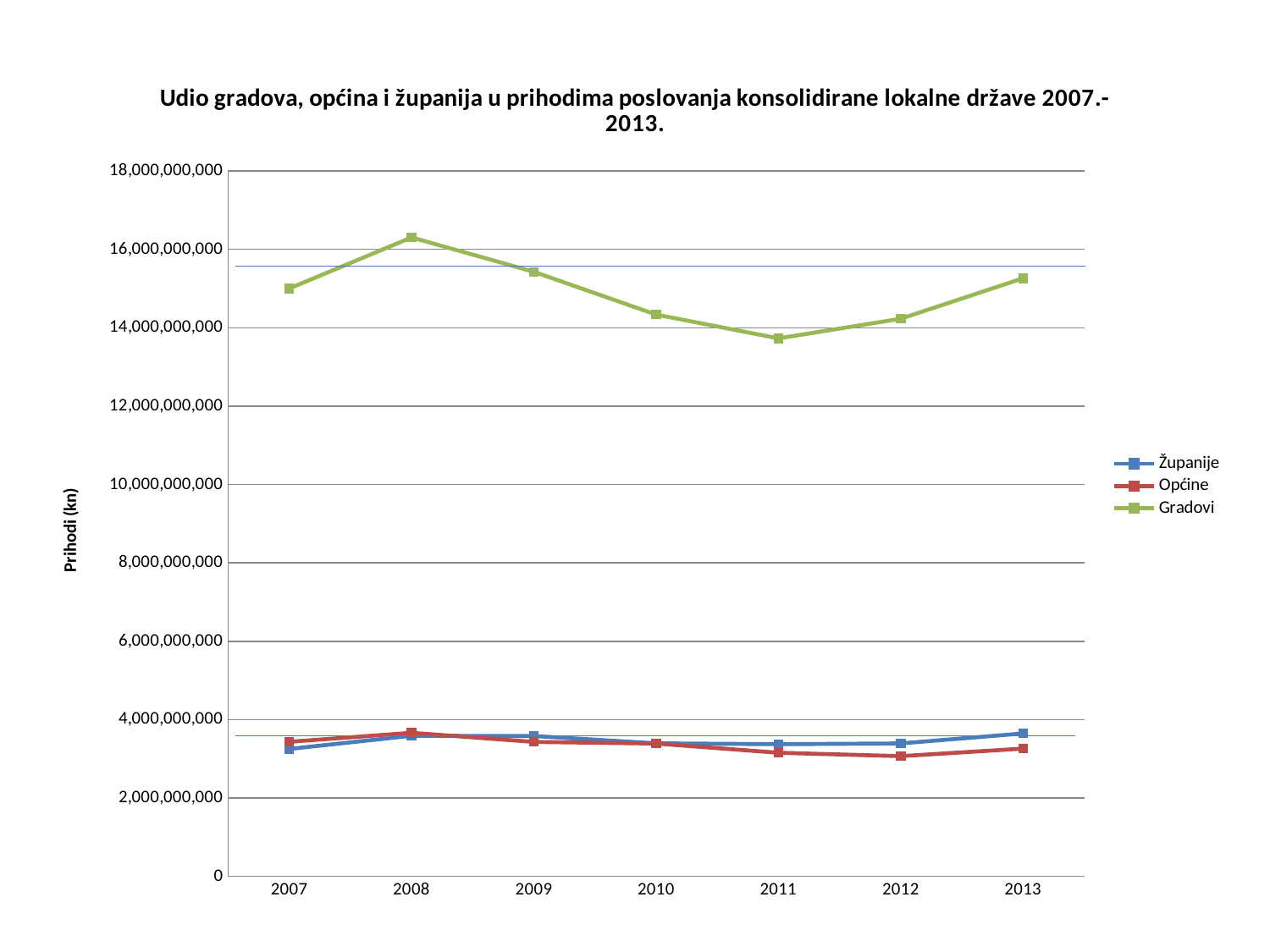
Does the Gradovi series rise or fall from 2008 to 2011? fall Which series has the larger value in 2013, Županije or Općine? Županije Is the value for Općine in 2012 greater or less than 4,000,000,000? less Is the value for Gradovi in 2008 greater or less than 16,000,000,000? greater How many series does the legend list? 3 In which year does the Gradovi series reach its lowest value? 2011 What kind of chart is shown on the slide? line chart What is the label on the y axis? Prihodi (kn) How many years are plotted along the x axis? 7 Which series has the larger value in 2010, Gradovi or Općine? Gradovi In which year does the Gradovi series reach its highest value? 2008 Is the value for Gradovi in 2011 greater or less than 14,000,000,000? less